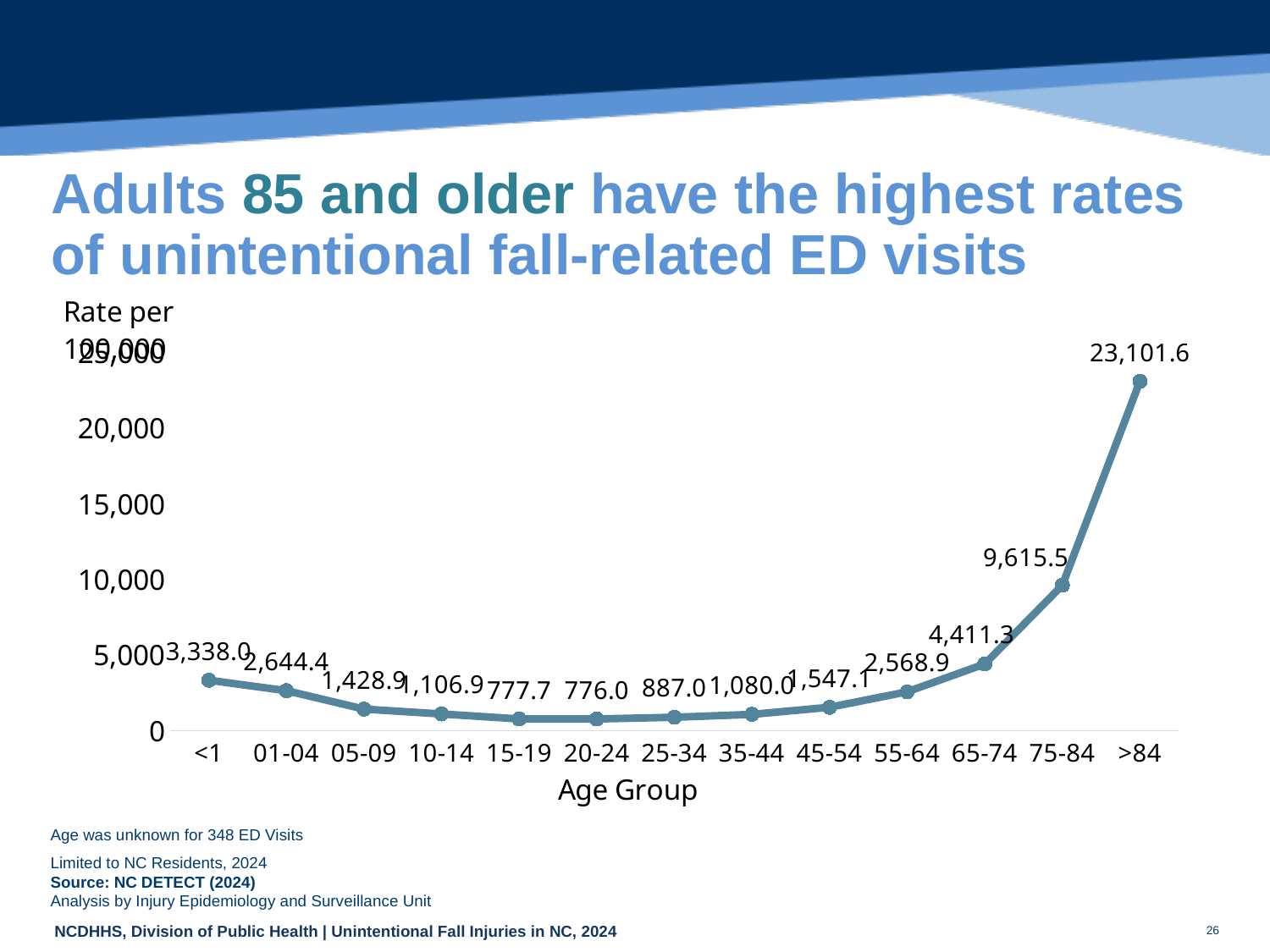
What is the rate per 100,000 for the 75-84 age group? 9,615.5 Which age group has the highest rate of unintentional fall-related ED visits? >84 Which age group has a higher rate, 65-74 or 55-64? 65-74 Is the value for the 75-84 age group greater or less than 10,000? less What is the difference between the rates for the >84 and 75-84 age groups? 13,486.1 What is the rate per 100,000 for the 45-54 age group? 1,547.1 What is the rate per 100,000 for the <1 age group? 3,338.0 What is the difference between the rates for the <1 and 01-04 age groups? 693.6 What is the rate per 100,000 for the >84 age group? 23,101.6 What type of chart is shown on the slide? line chart How many age groups are plotted on the x axis? 13 What is the title of the x axis? Age Group